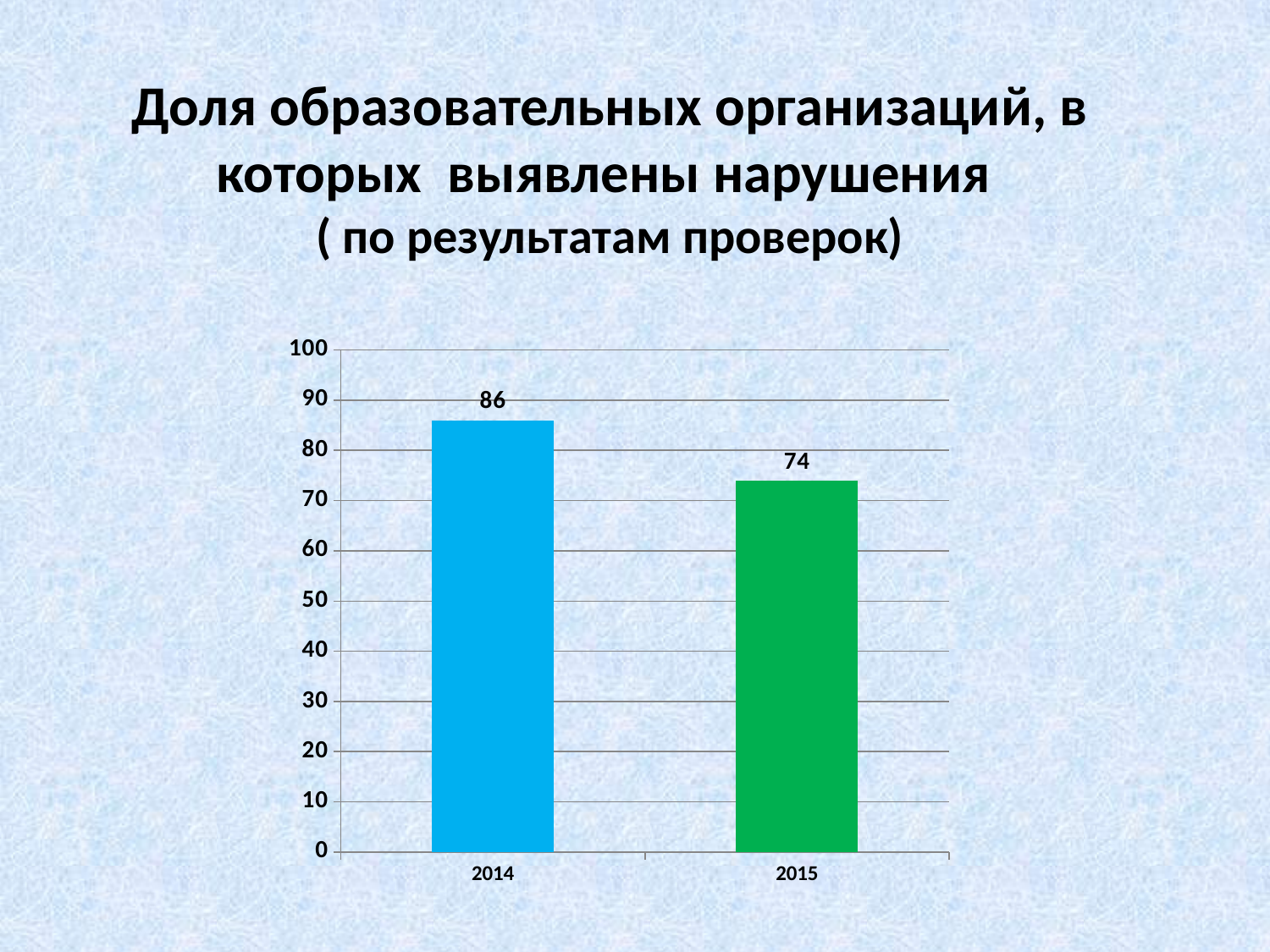
What is the value for 2015? 74 What is the value for 2014? 86 How many categories are shown on the x axis? 2 Is the value for 2014 greater or less than 80? greater What is the difference between the values for 2014 and 2015? 12 Is the value for 2015 greater or less than 80? less What colour is the bar for 2015? green What kind of chart is shown on the slide? bar chart Which year has the highest value? 2014 Which is larger, the value for 2014 or the value for 2015? 2014 Which year has the lowest value? 2015 Do the values rise or fall from 2014 to 2015? fall